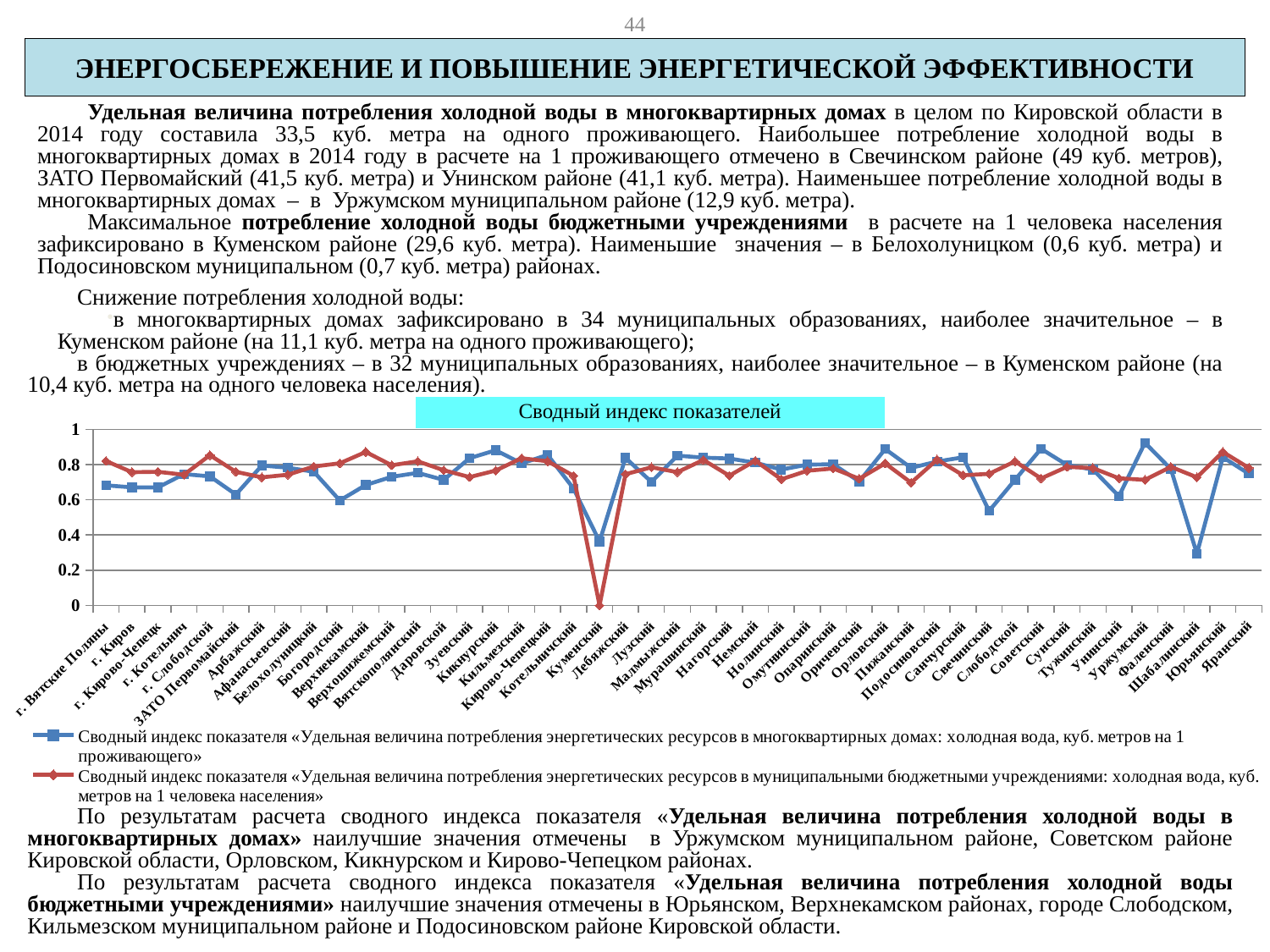
What is the title of the chart? Сводный индекс показателей How many series does the chart legend list? 2 Which category has the lowest value for the red series (бюджетными учреждениями)? Куменский Is the value of the blue series (многоквартирных домах) for Шабалинский greater or less than 0.4? less What kind of chart is shown on the slide? line chart Is the value of the blue series (многоквартирных домах) for Лебяжский greater or less than 0.6? greater For Свечинский, which series has the larger value: the blue series (многоквартирных домах) or the red series (бюджетными учреждениями)? red series (бюджетными учреждениями) Is the value of the blue series (многоквартирных домах) for Уржумский greater or less than 0.8? greater Which colour is used for the series about cold water consumption in apartment buildings (многоквартирных домах)? blue For Уржумский, which series has the larger value: the blue series (многоквартирных домах) or the red series (бюджетными учреждениями)? blue series (многоквартирных домах)